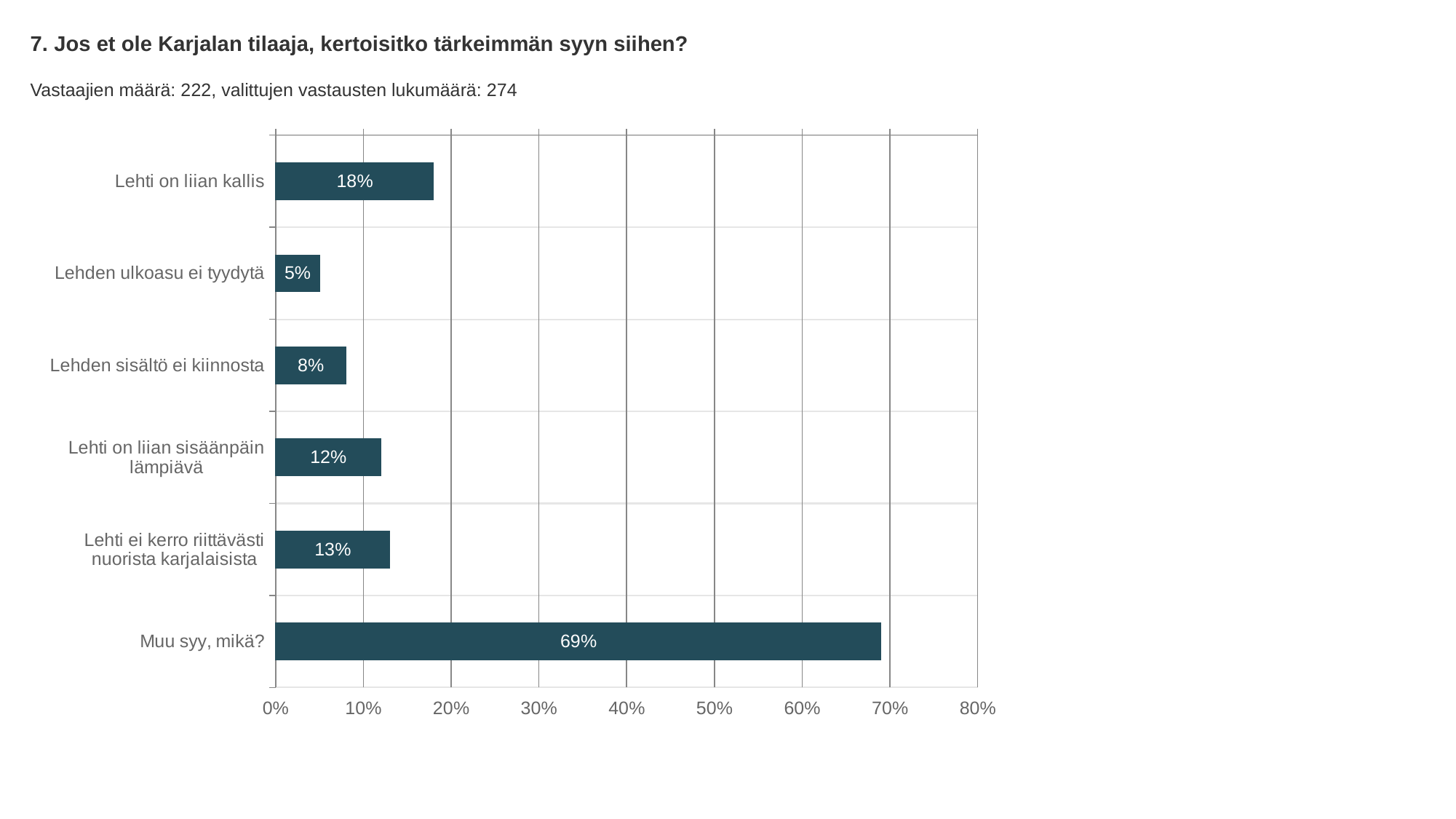
What percentage is shown for "Lehti on liian kallis"? 18% What percentage is shown for "Lehti ei kerro riittävästi nuorista karjalaisista"? 13% Which is larger: the value for "Lehti on liian sisäänpäin lämpiävä" or the value for "Lehti ei kerro riittävästi nuorista karjalaisista"? Lehti ei kerro riittävästi nuorista karjalaisista What percentage is shown for "Muu syy, mikä?"? 69% What is the difference in percentage points between "Muu syy, mikä?" and "Lehti on liian kallis"? 51 What kind of chart is shown on the slide? bar chart Which category has the highest percentage? Muu syy, mikä? Which category has the lowest percentage? Lehden ulkoasu ei tyydytä Is the value for "Muu syy, mikä?" greater or less than 60%? greater What percentage is shown for "Lehden sisältö ei kiinnosta"? 8% What is the number of respondents (Vastaajien määrä) stated on the slide? 222 How many categories are shown in the chart? 6